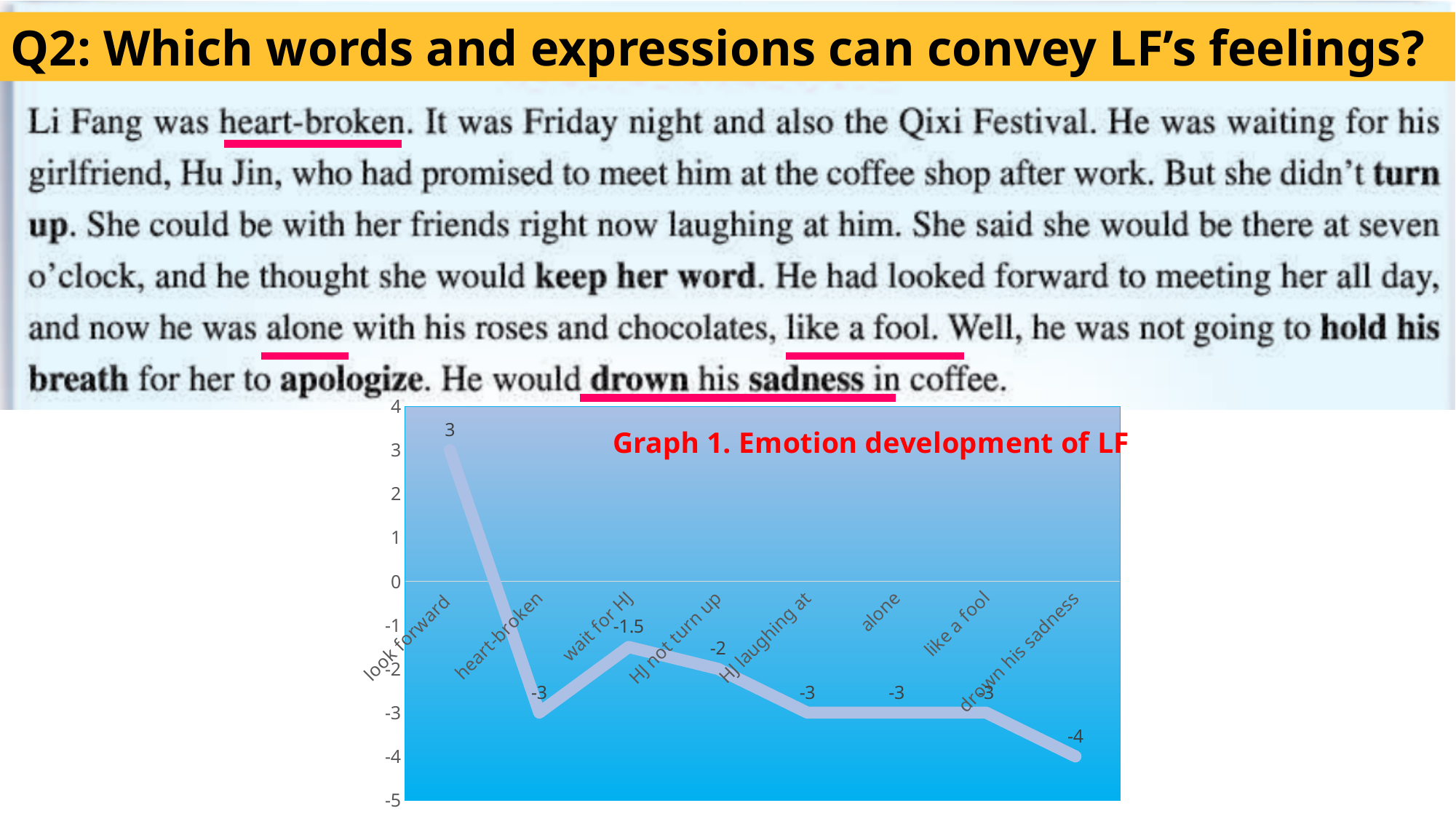
What is the value for 'heart-broken' in Graph 1? -3 What is the value for 'wait for HJ' in Graph 1? -1.5 What type of chart is Graph 1. Emotion development of LF? line chart What is the title of the chart on the slide? Graph 1. Emotion development of LF How many categories are plotted along the x axis in Graph 1? 8 What is the difference between the values for 'look forward' and 'heart-broken' in Graph 1? 6 What is the value for 'look forward' in Graph 1? 3 Which category has the highest value in Graph 1? look forward Which is larger in Graph 1, the value for 'wait for HJ' or the value for 'HJ not turn up'? wait for HJ What is the value for 'HJ not turn up' in Graph 1? -2 What is the value for 'drown his sadness' in Graph 1? -4 Which category has the lowest value in Graph 1? drown his sadness